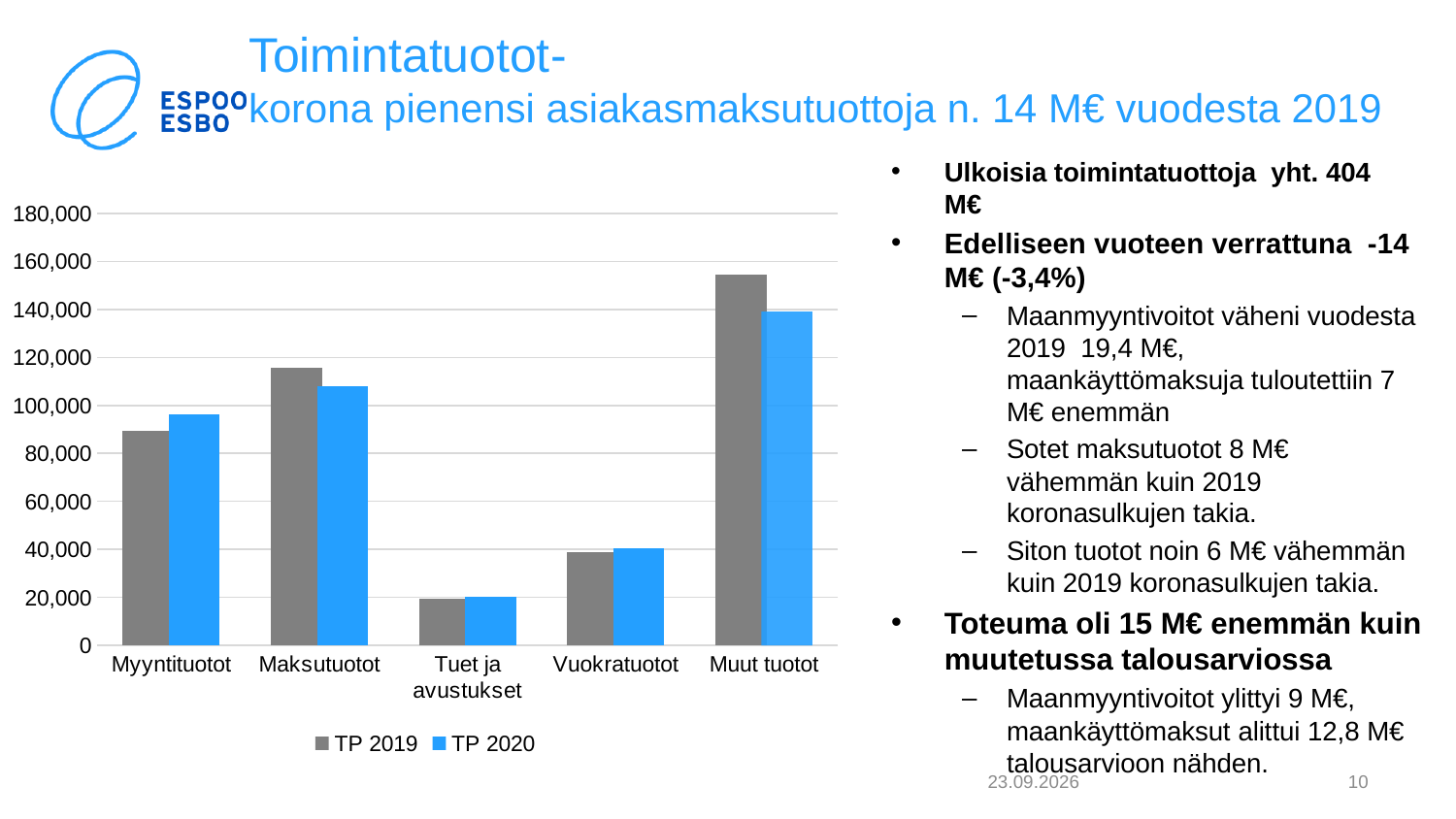
Is the TP 2020 value for Myyntituotot greater or less than 100,000? less How many categories are shown on the x axis of the chart? 5 Which category has the highest TP 2020 value? Muut tuotot For Myyntituotot, which is larger: TP 2019 or TP 2020? TP 2020 Which category has the lowest TP 2019 value? Tuet ja avustukset Which colour represents the TP 2020 series in the chart? blue For Maksutuotot, which is larger: TP 2019 or TP 2020? TP 2019 Which category has the highest TP 2019 value? Muut tuotot What kind of chart is shown on the slide? bar chart Is the TP 2019 value for Maksutuotot greater or less than 100,000? greater How many series does the chart legend list? 2 Is the TP 2019 value for Muut tuotot greater or less than 140,000? greater